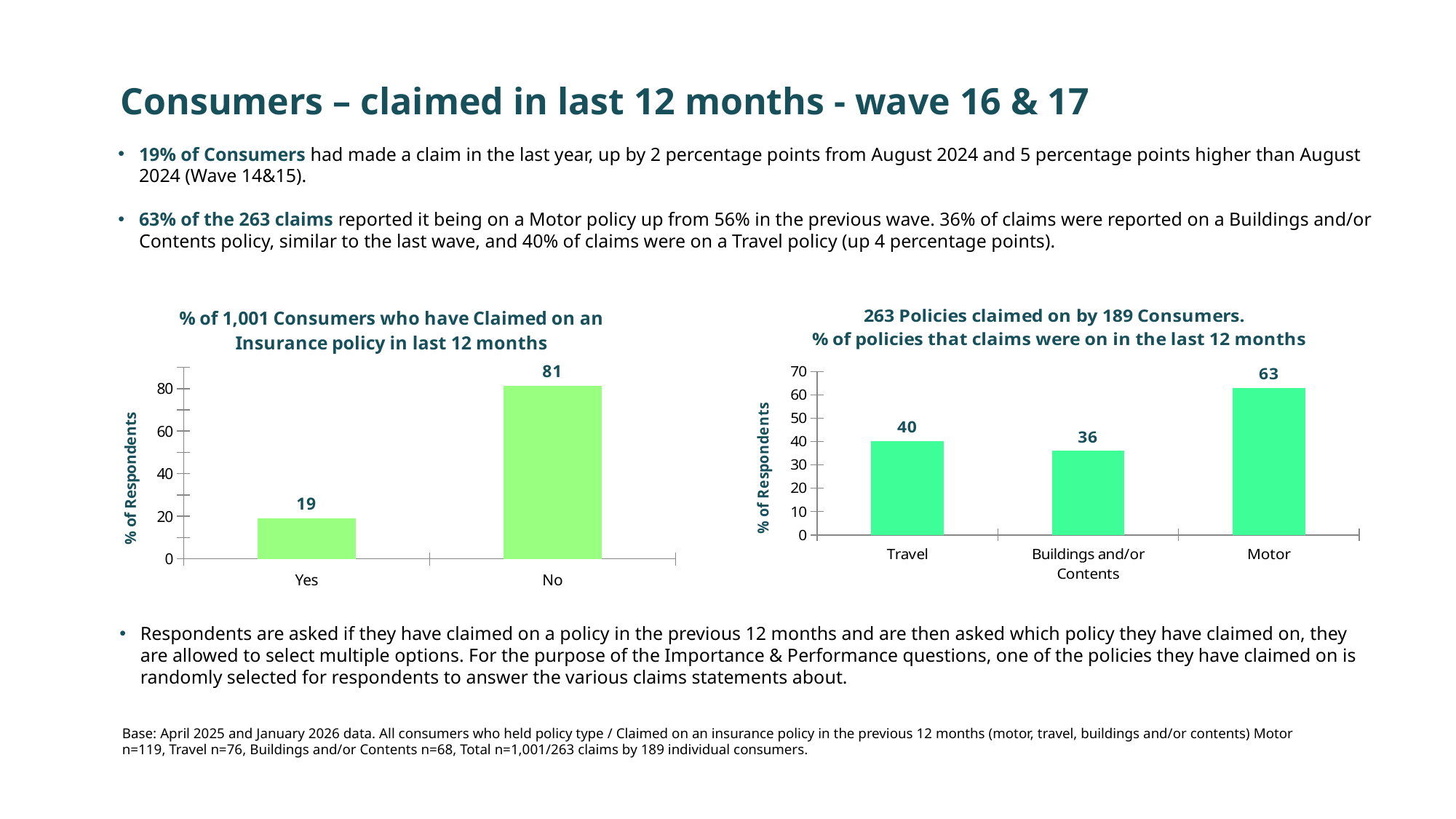
In the right chart (263 Policies claimed on by 189 Consumers), what is the value for Travel? 40 In the right chart (263 Policies claimed on by 189 Consumers), how many categories are shown? 3 In the right chart (263 Policies claimed on by 189 Consumers), which is larger, Travel or Buildings and/or Contents? Travel In the left chart (% of 1,001 Consumers who have Claimed on an Insurance policy in last 12 months), what is the difference between the No and Yes values? 62 In the right chart (263 Policies claimed on by 189 Consumers), what is the difference between the Motor and Travel values? 23 In the right chart (263 Policies claimed on by 189 Consumers), which category has the lowest value? Buildings and/or Contents What kind of chart is the right chart (263 Policies claimed on by 189 Consumers)? Bar chart In the left chart (% of 1,001 Consumers who have Claimed on an Insurance policy in last 12 months), what is the value for No? 81 In the right chart (263 Policies claimed on by 189 Consumers), what is the value for Buildings and/or Contents? 36 In the left chart (% of 1,001 Consumers who have Claimed on an Insurance policy in last 12 months), what is the value for Yes? 19 In the right chart (263 Policies claimed on by 189 Consumers), which category has the highest value? Motor In the left chart (% of 1,001 Consumers who have Claimed on an Insurance policy in last 12 months), how many categories are shown? 2